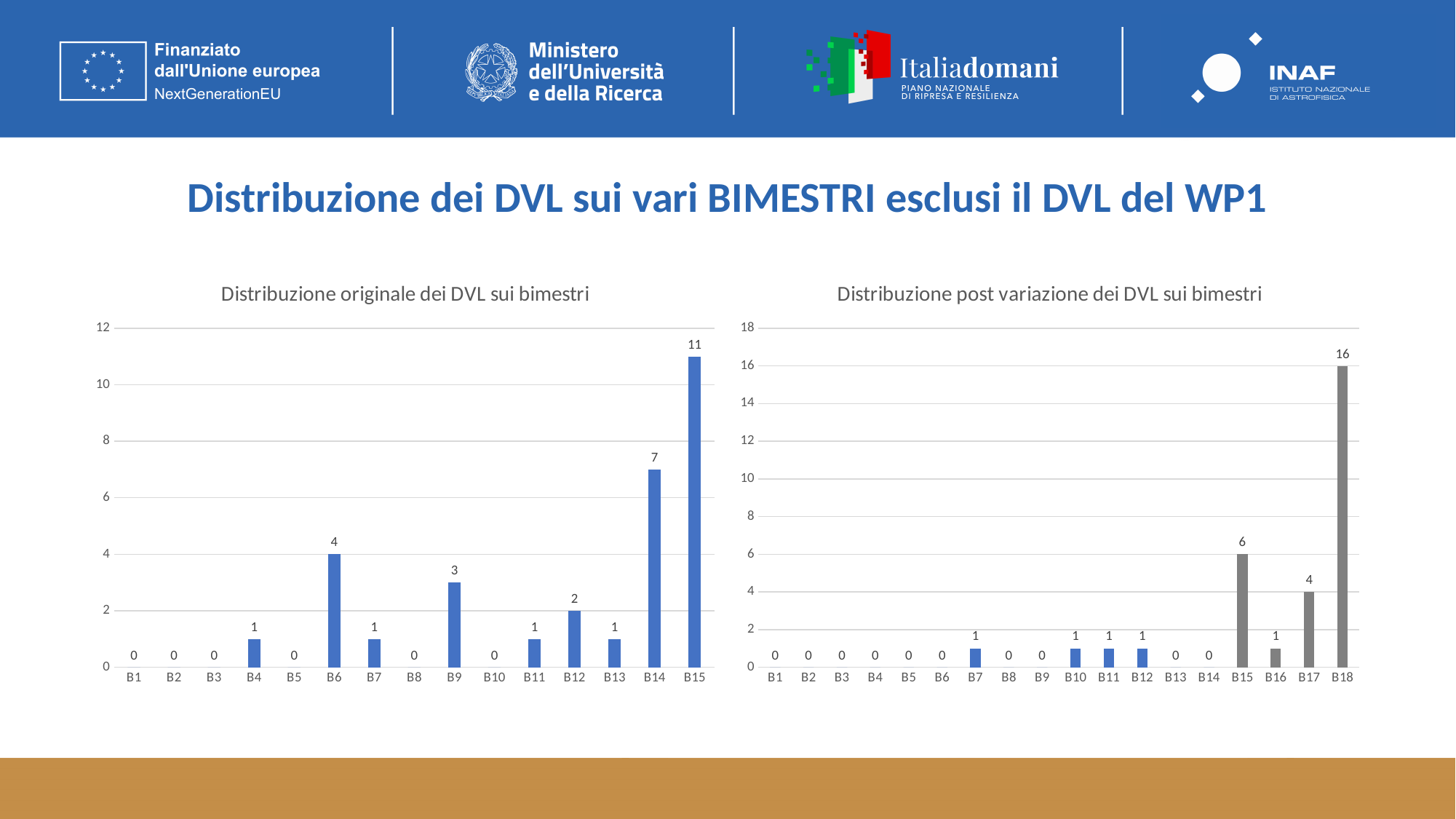
How many bimestri are shown on the x axis of the chart 'Distribuzione originale dei DVL sui bimestri'? 15 In the chart 'Distribuzione originale dei DVL sui bimestri', which bimestre has the highest value? B15 In the chart 'Distribuzione post variazione dei DVL sui bimestri', what is the value for B15? 6 In the chart 'Distribuzione post variazione dei DVL sui bimestri', what is the difference between the values for B18 and B17? 12 How many bimestri are shown on the x axis of the chart 'Distribuzione post variazione dei DVL sui bimestri'? 18 In the chart 'Distribuzione post variazione dei DVL sui bimestri', what is the value for B18? 16 What kind of chart is 'Distribuzione originale dei DVL sui bimestri'? Bar chart In the chart 'Distribuzione originale dei DVL sui bimestri', which is larger, the value for B9 or the value for B12? B9 In the chart 'Distribuzione originale dei DVL sui bimestri', what is the difference between the values for B15 and B14? 4 In the chart 'Distribuzione post variazione dei DVL sui bimestri', which bimestre has the highest value? B18 In the chart 'Distribuzione originale dei DVL sui bimestri', what is the value for B15? 11 In the chart 'Distribuzione originale dei DVL sui bimestri', what is the value for B6? 4